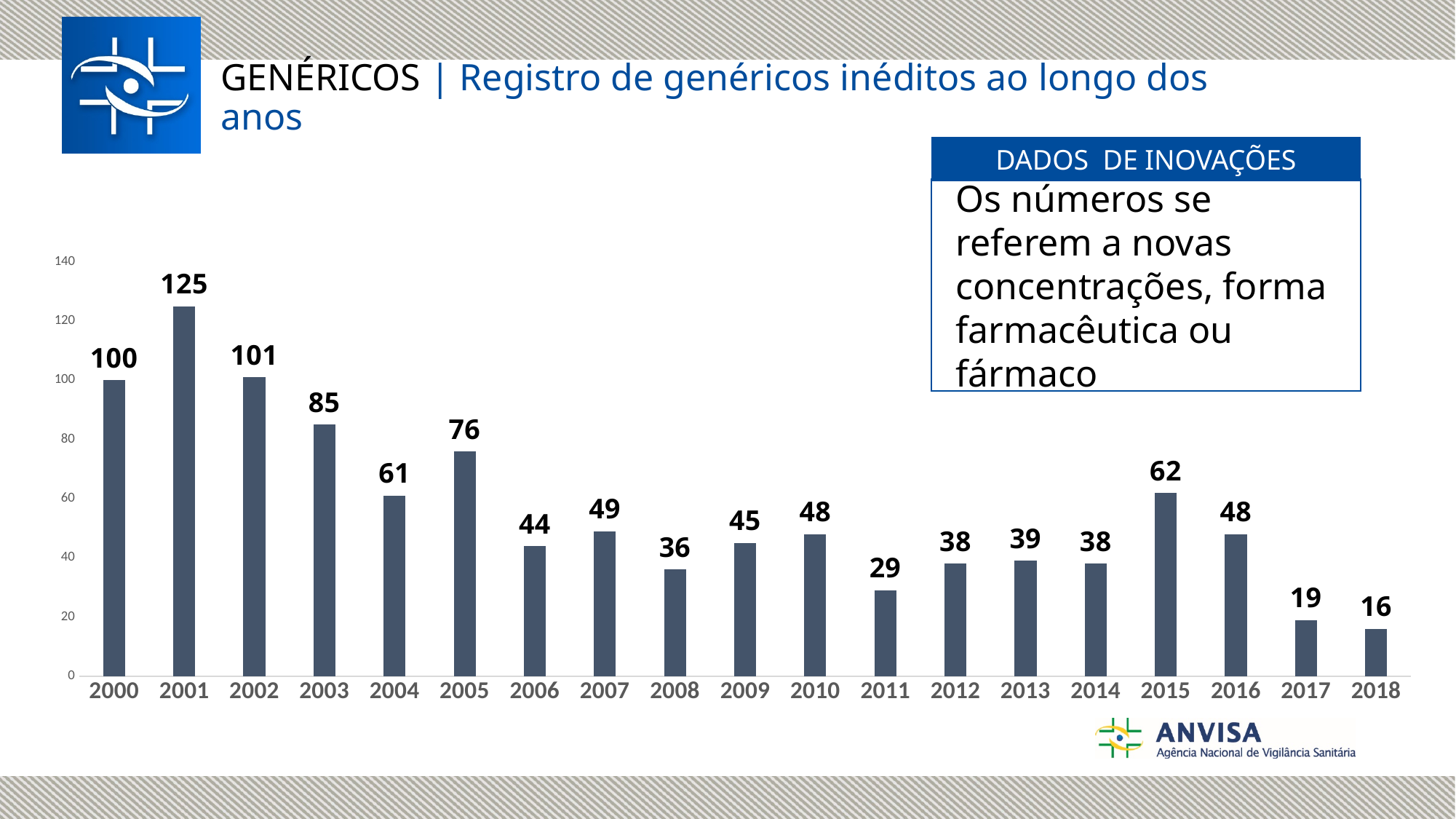
Which year has the highest value? 2001 Do the values generally rise or fall from 2000 to 2018? fall How many years are shown on the x axis? 19 What is the difference between the values for 2000 and 2018? 84 What is the value for 2001? 125 What kind of chart is shown on the slide? bar chart Which year has the lowest value? 2018 Is the value for 2003 greater or less than 80? greater What is the difference between the values for 2016 and 2017? 29 What is the value for 2011? 29 What is the value for 2015? 62 Which is larger, the value for 2005 or the value for 2015? 2005